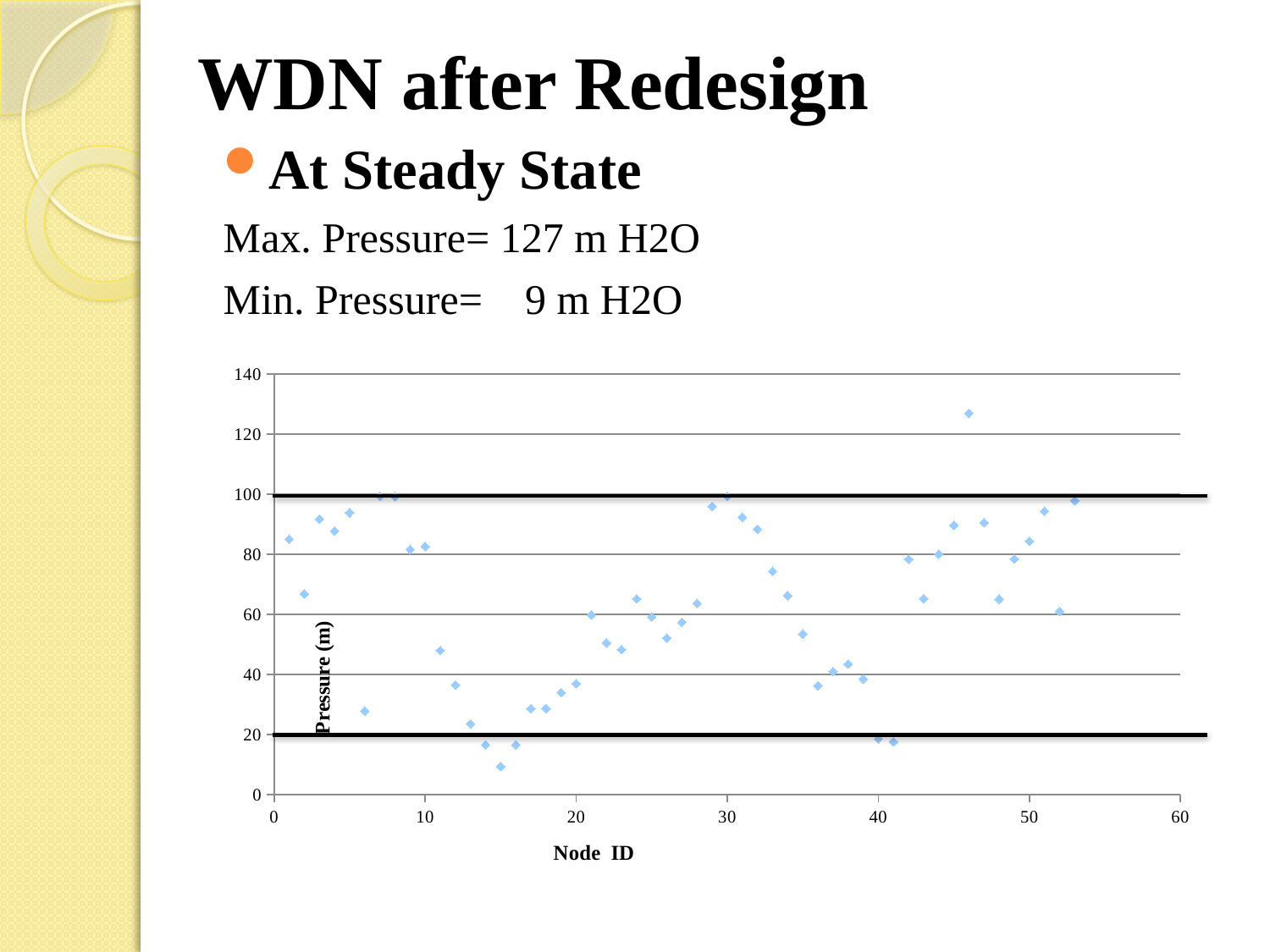
According to the slide, what is the minimum pressure at steady state? 9 m H2O Is the pressure value for Node ID 33 greater or less than 60? greater According to the slide, what is the maximum pressure at steady state? 127 m H2O Is the pressure value for Node ID 15 greater or less than 20? less Which Node ID has the highest pressure in the chart? 46 What is the title of the x axis of the chart? Node ID Is the pressure value for Node ID 46 greater or less than 120? greater What is the title of the y axis of the chart? Pressure (m) What kind of chart is shown on the slide? scatter chart Which Node ID has the lowest pressure in the chart? 15